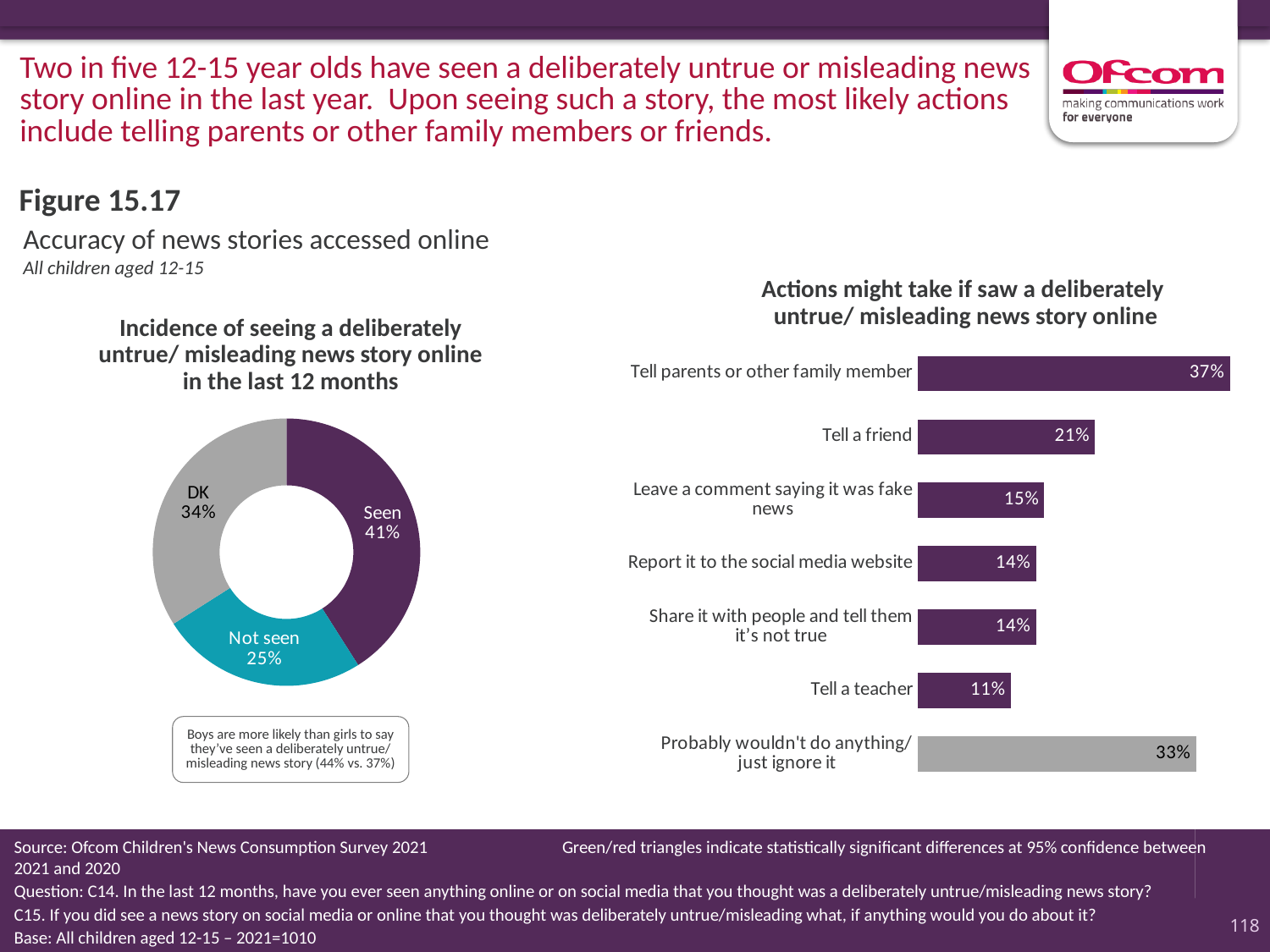
What kind of chart is the 'Actions might take if saw a deliberately untrue/ misleading news story online' chart? Bar chart In the 'Incidence of seeing a deliberately untrue/ misleading news story online in the last 12 months' chart, what share answered DK? 34% In the 'Actions might take if saw a deliberately untrue/ misleading news story online' chart, what is the value for 'Tell a teacher'? 11% How many categories are shown in the 'Actions might take if saw a deliberately untrue/ misleading news story online' chart? 7 In the 'Incidence of seeing a deliberately untrue/ misleading news story online in the last 12 months' chart, what share of children said they had seen such a story? 41% In the 'Actions might take if saw a deliberately untrue/ misleading news story online' chart, what is the value for 'Tell a friend'? 21% In the 'Incidence of seeing a deliberately untrue/ misleading news story online in the last 12 months' chart, which category has the smallest share? Not seen In the 'Incidence of seeing a deliberately untrue/ misleading news story online in the last 12 months' chart, how many slices are there? 3 In the 'Actions might take if saw a deliberately untrue/ misleading news story online' chart, which is larger: 'Leave a comment saying it was fake news' or 'Tell a teacher'? Leave a comment saying it was fake news In the 'Actions might take if saw a deliberately untrue/ misleading news story online' chart, which action has the highest value? Tell parents or other family member In the 'Actions might take if saw a deliberately untrue/ misleading news story online' chart, what is the difference between 'Tell parents or other family member' and 'Probably wouldn't do anything/ just ignore it'? 4 percentage points What kind of chart is the 'Incidence of seeing a deliberately untrue/ misleading news story online in the last 12 months' chart? Pie (doughnut) chart